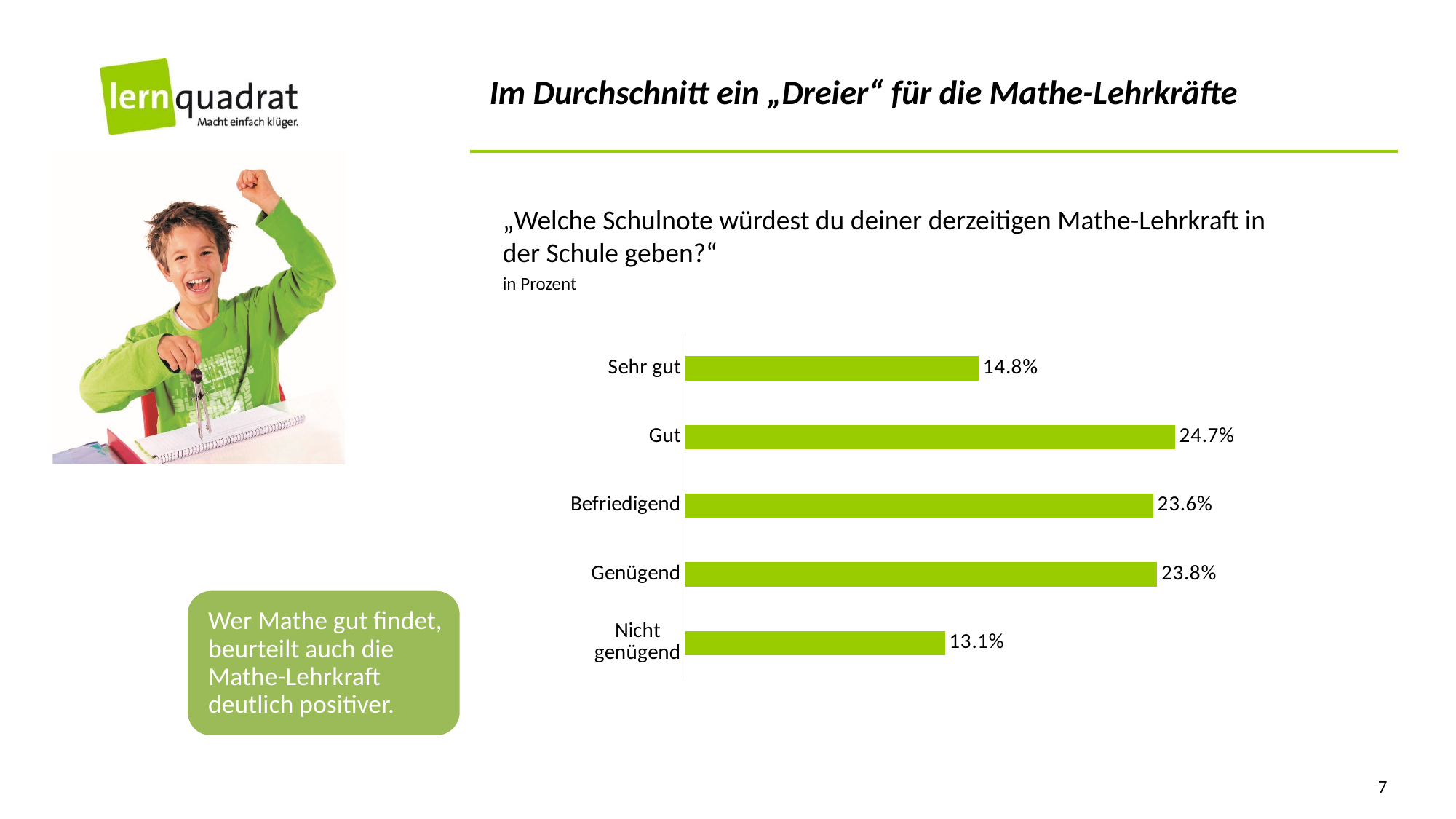
What is the value for "Befriedigend"? 23.6% Which grade received the highest percentage? Gut What percentage is shown for "Nicht genügend"? 13.1% What unit are the chart values given in, according to the text above the chart? in Prozent What is the value shown for "Gut"? 24.7% What is the difference between the values for "Genügend" and "Nicht genügend"? 10.7% Which has a larger value, "Sehr gut" or "Nicht genügend"? Sehr gut What percentage of respondents gave their maths teacher the grade "Sehr gut"? 14.8% What is the difference in percentage points between "Gut" and "Sehr gut"? 9.9 What type of chart is shown on the slide? Bar chart Which grade received the lowest percentage? Nicht genügend How many grade categories are shown in the chart? 5